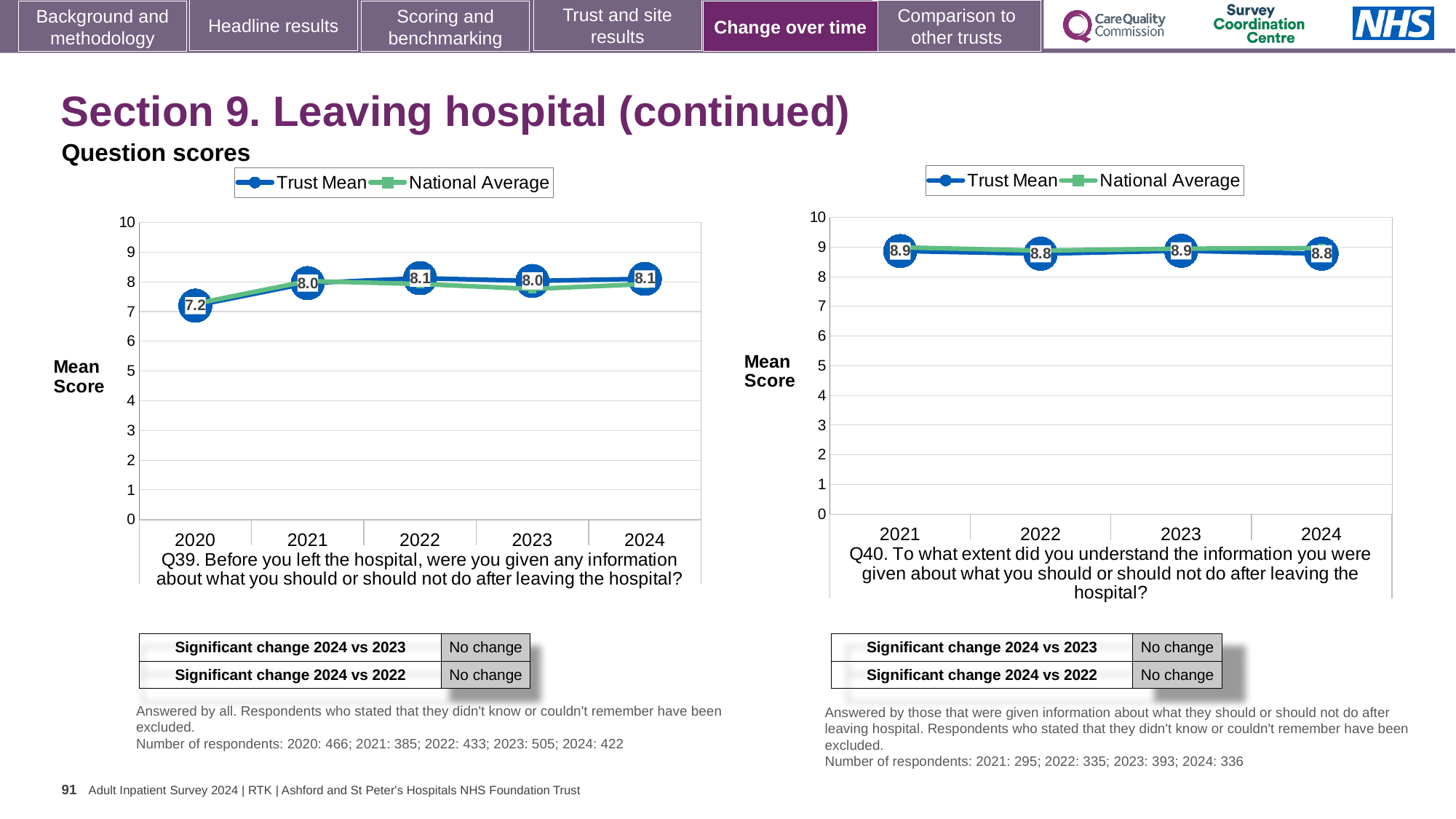
On the Q39 chart (left), what is the Trust Mean score for 2020? 7.2 On the Q40 chart (right), is the National Average for 2024 greater or less than 8? greater On the Q40 chart (right), what is the Trust Mean score for 2021? 8.9 On the Q39 chart (left), is the Trust Mean score for 2020 greater or less than 8? less On the Q40 chart (right), what is the Trust Mean score for 2022? 8.8 On the Q40 chart (right), how many years are shown on the x axis? 4 On the Q39 chart (left), what is the difference between the Trust Mean scores for 2021 and 2020? 0.8 On the Q39 chart (left), what is the Trust Mean score for 2024? 8.1 What type of chart is the Q39 chart (left)? Line chart On the Q39 chart (left), how many years are shown on the x axis? 5 On the Q39 chart (left), which year has the lowest Trust Mean score? 2020 How many series does the legend of the Q40 chart (right) list? 2